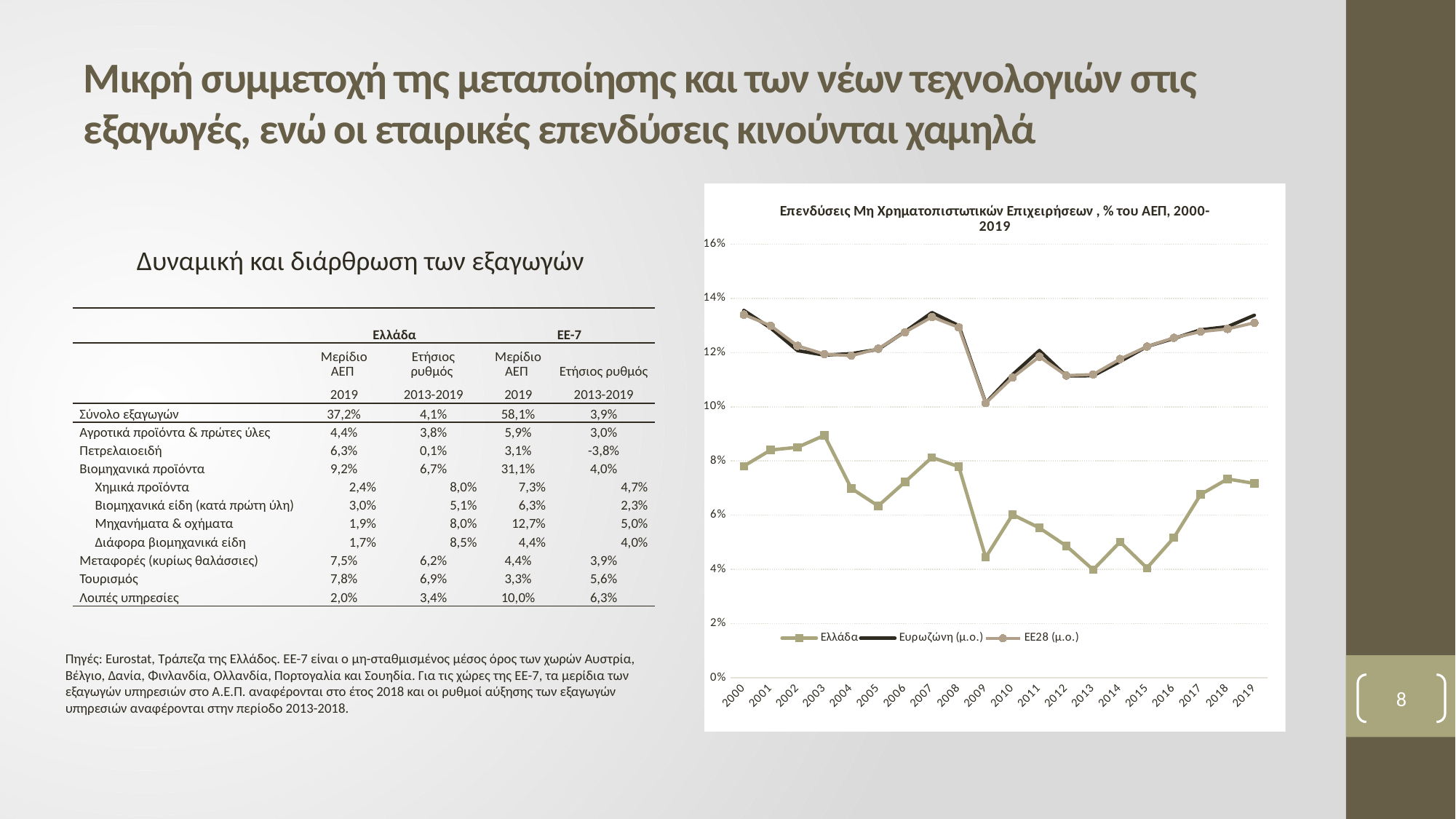
In the line chart, which is larger in 2010: the value for Ελλάδα or the value for Ευρωζώνη (μ.ο.)? Ευρωζώνη (μ.ο.) In the line chart, is the value for Ευρωζώνη (μ.ο.) in 2009 greater or less than 12%? less In the line chart, is the value for Ελλάδα in 2003 greater or less than 8%? greater How many years are plotted along the x axis of the line chart? 20 In the line chart, is the value for ΕΕ28 (μ.ο.) in 2000 greater or less than 12%? greater In the line chart, in which year does the Ελλάδα series reach its highest value? 2003 What kind of chart is shown on the right side of the slide? line chart In the line chart, in which year does the Ευρωζώνη (μ.ο.) series reach its lowest value? 2009 In the line chart, does the Ελλάδα series rise or fall between 2013 and 2018? rise What is the title of the line chart? Επενδύσεις Μη Χρηματοπιστωτικών Επιχειρήσεων , % του ΑΕΠ, 2000-2019 How many series does the legend of the line chart list? 3